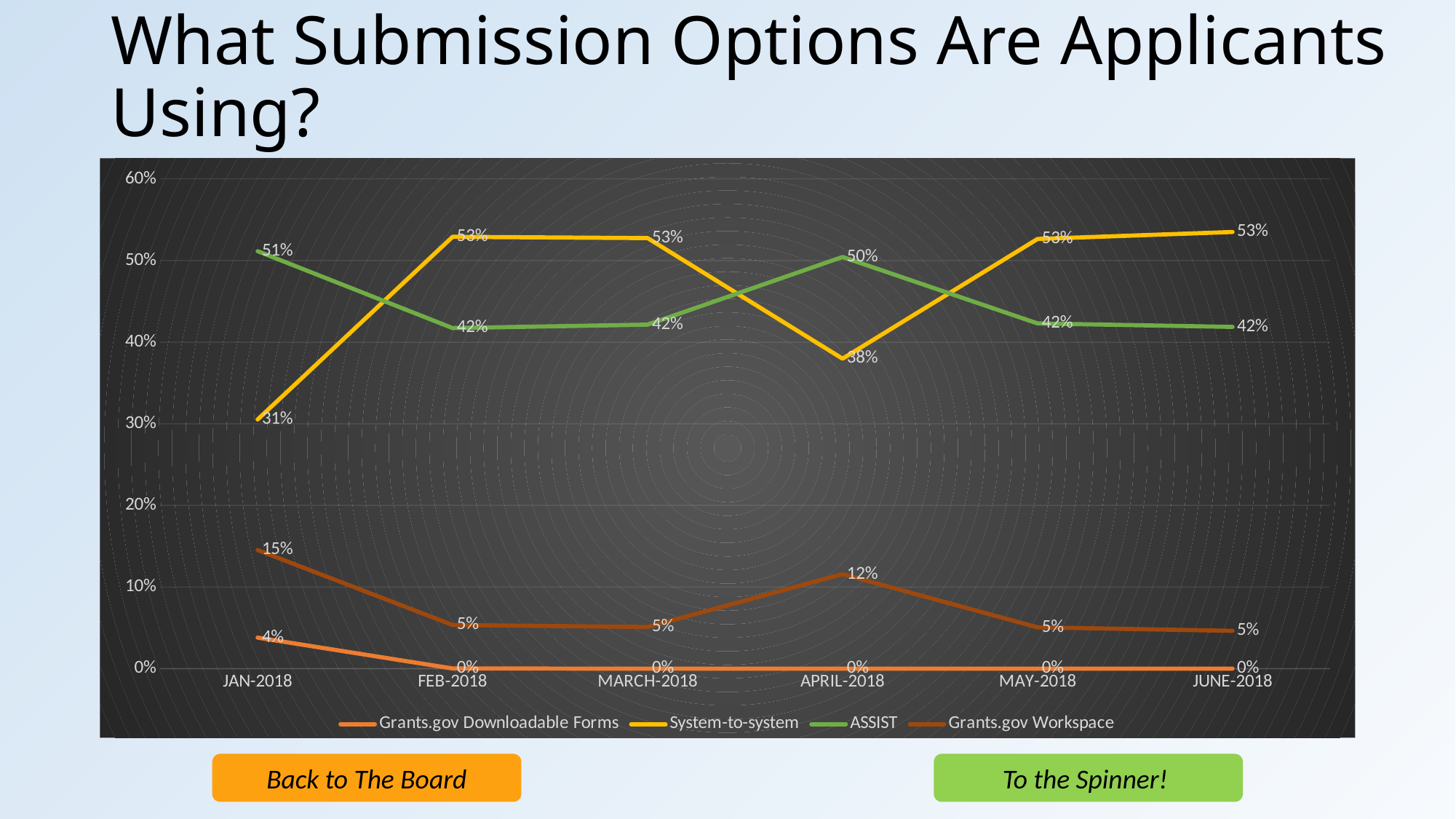
What is the value for Grants.gov Workspace in JAN-2018? 15% In which month is the System-to-system value lowest? JAN-2018 What type of chart is shown on the slide? Line chart What is the value for System-to-system in JAN-2018? 31% In which month is the Grants.gov Workspace value highest? JAN-2018 Which series has the larger value in APRIL-2018, System-to-system or ASSIST? ASSIST What is the difference between the System-to-system and ASSIST values in JUNE-2018? 11% What is the value for Grants.gov Downloadable Forms in JAN-2018? 4% How many series does the legend list? 4 What is the value for ASSIST in APRIL-2018? 50% Does the Grants.gov Downloadable Forms line rise or fall from JAN-2018 to FEB-2018? Fall How many months are shown on the x axis? 6